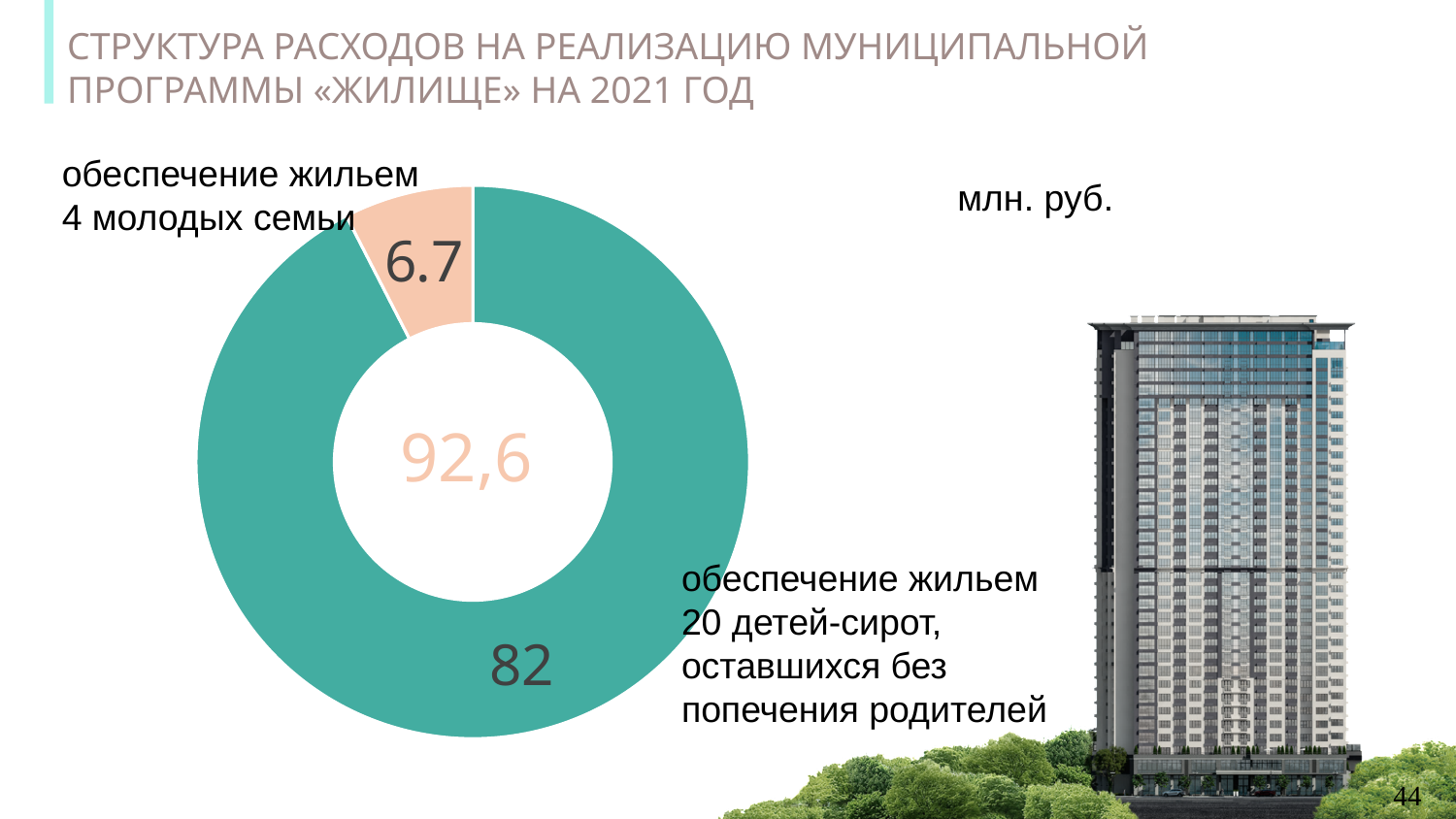
What number is printed in the centre of the donut chart? 92,6 What is the value for «обеспечение жильем 4 молодых семьи»? 6.7 Which is larger: the value for housing for 4 young families or the value for housing for 20 orphans? обеспечение жильем 20 детей-сирот, оставшихся без попечения родителей Is the value for housing for 4 young families greater or less than 10? less Which category has the smallest slice of the chart? обеспечение жильем 4 молодых семьи What is the difference between the value for housing for 20 orphans (82) and the value for housing for 4 young families (6.7)? 75.3 Which category has the largest slice of the chart? обеспечение жильем 20 детей-сирот, оставшихся без попечения родителей What is the value for «обеспечение жильем 20 детей-сирот, оставшихся без попечения родителей»? 82 What unit of measurement is indicated for the chart values? млн. руб. What kind of chart is shown on the slide? Donut (pie) chart How many slices does the chart have? 2 Is the value for housing for 20 orphans greater or less than 50? greater